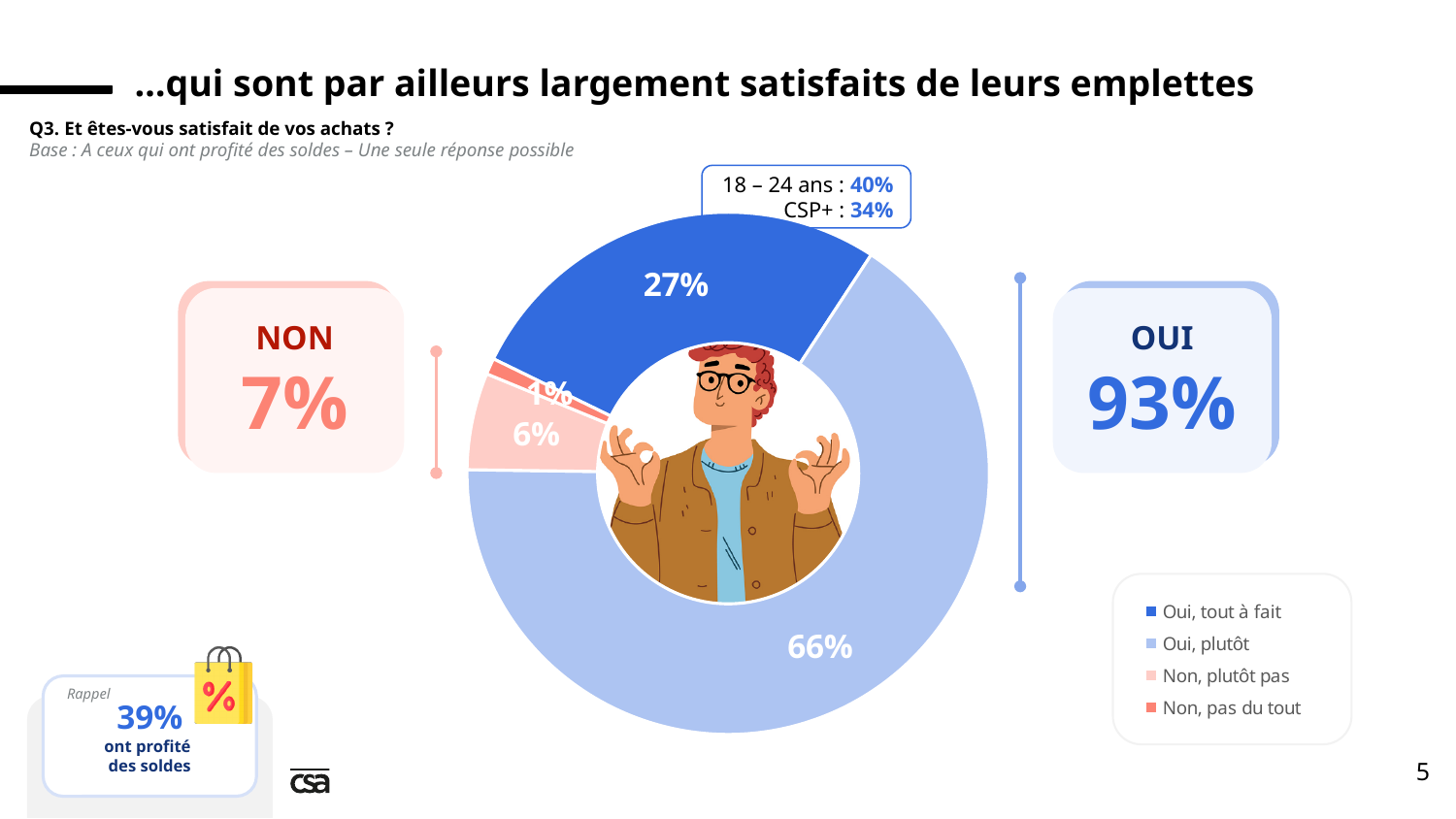
What kind of chart is shown on the slide? Pie (donut) chart What percentage of respondents answered "Oui, tout à fait"? 27% How many entries does the legend list? 4 Which response category has the largest share of the pie? Oui, plutôt What is the combined share of the two "Oui" responses, as shown in the OUI box? 93% Which response category has the smallest share of the pie? Non, pas du tout What percentage of respondents answered "Non, plutôt pas"? 6% What is the difference in percentage points between "Oui, plutôt" and "Oui, tout à fait"? 39 percentage points How many response categories are shown in the pie chart? 4 According to the callout above the chart, what is the "Oui, tout à fait" share among 18–24 ans? 40% What percentage of respondents answered "Oui, plutôt"? 66% Which is larger: the share for "Oui, tout à fait" or the share for "Non, plutôt pas"? Oui, tout à fait